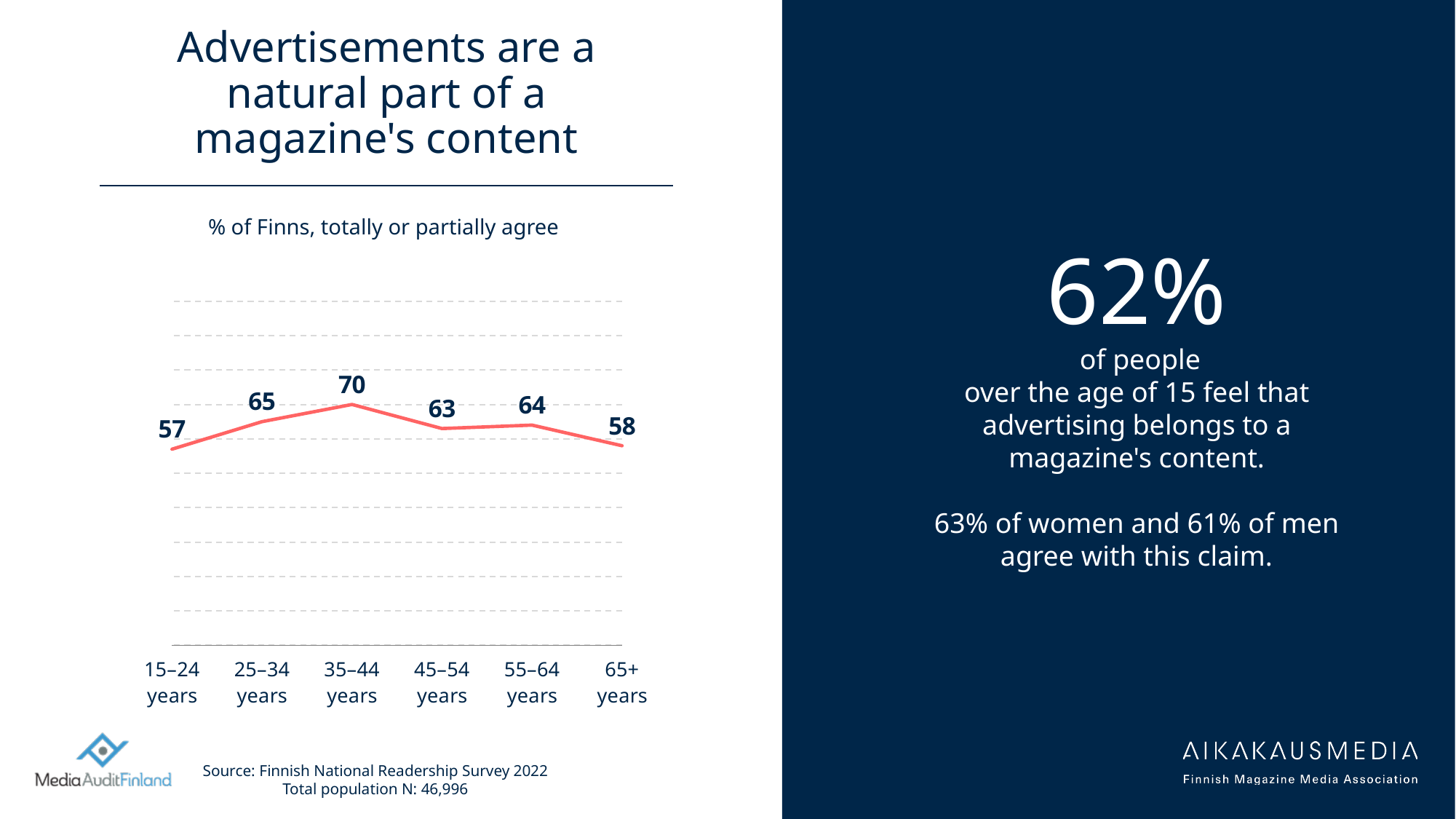
What is the difference between the values for 35–44 years and 15–24 years? 13 Does the value rise or fall from 55–64 years to 65+ years? fall Which age group has the highest value? 35–44 years Which age group has the lowest value? 15–24 years Which is larger, the value for 25–34 years or the value for 45–54 years? 25–34 years What kind of chart is shown on the slide? line chart What is the difference between the values for 55–64 years and 45–54 years? 1 How many age groups are plotted on the chart? 6 What does the subtitle above the chart say the values represent? % of Finns, totally or partially agree What is the value for the 35–44 years age group? 70 What is the value for the 65+ years age group? 58 What is the value for the 15–24 years age group? 57